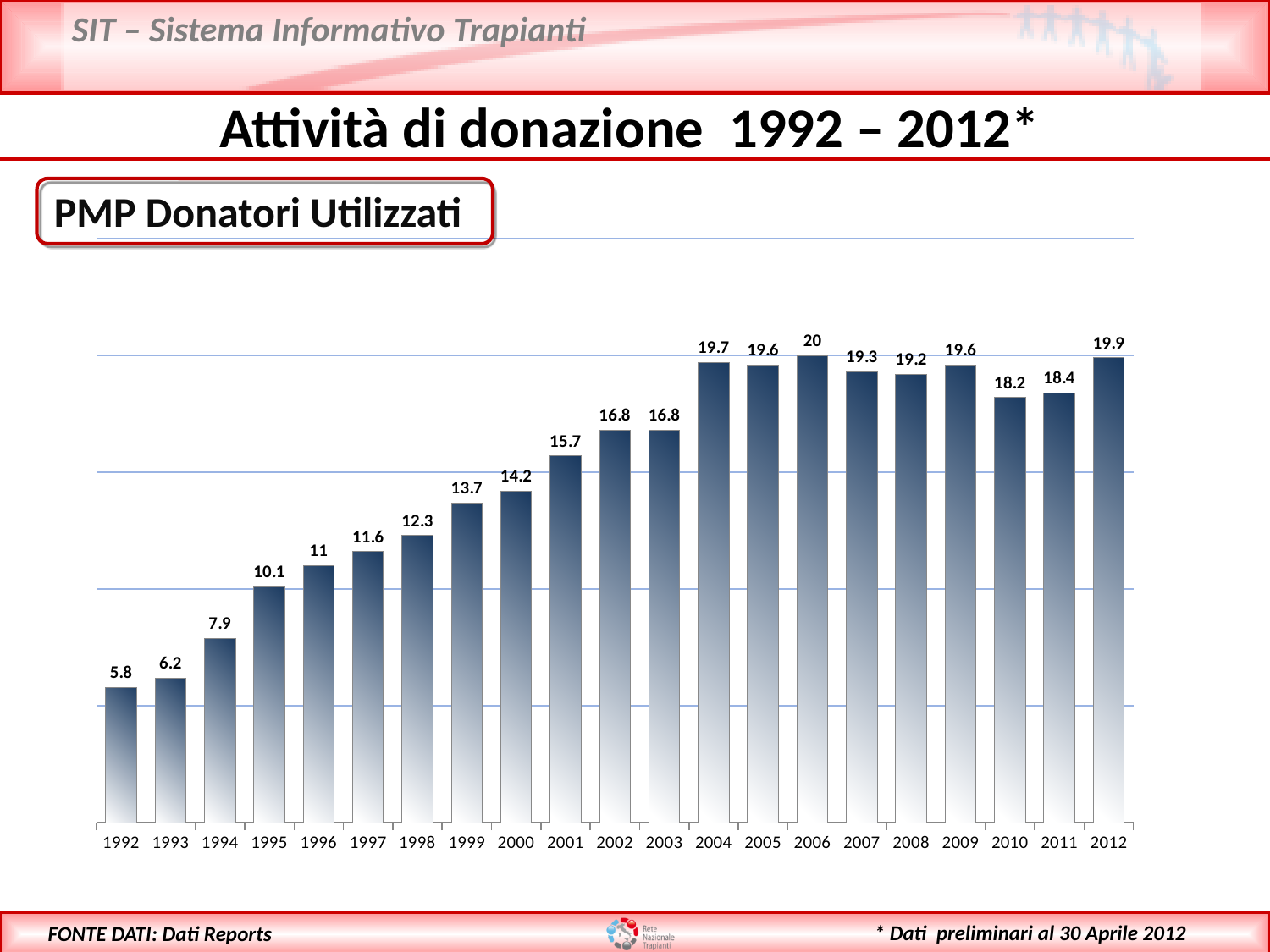
What is the title shown in the box above the chart? PMP Donatori Utilizzati Which year has the highest value? 2006 What is the value for 1999? 13.7 What kind of chart is shown? bar chart Which year has the lowest value? 1992 What is the value for 2006? 20 What is the value for 1992? 5.8 How many years are shown on the x axis? 21 Which is larger, the value for 2010 or the value for 2011? 2011 Do the values generally rise or fall from 1992 to 2004? rise What is the difference between the values for 2012 and 1992? 14.1 What is the value for 2012? 19.9